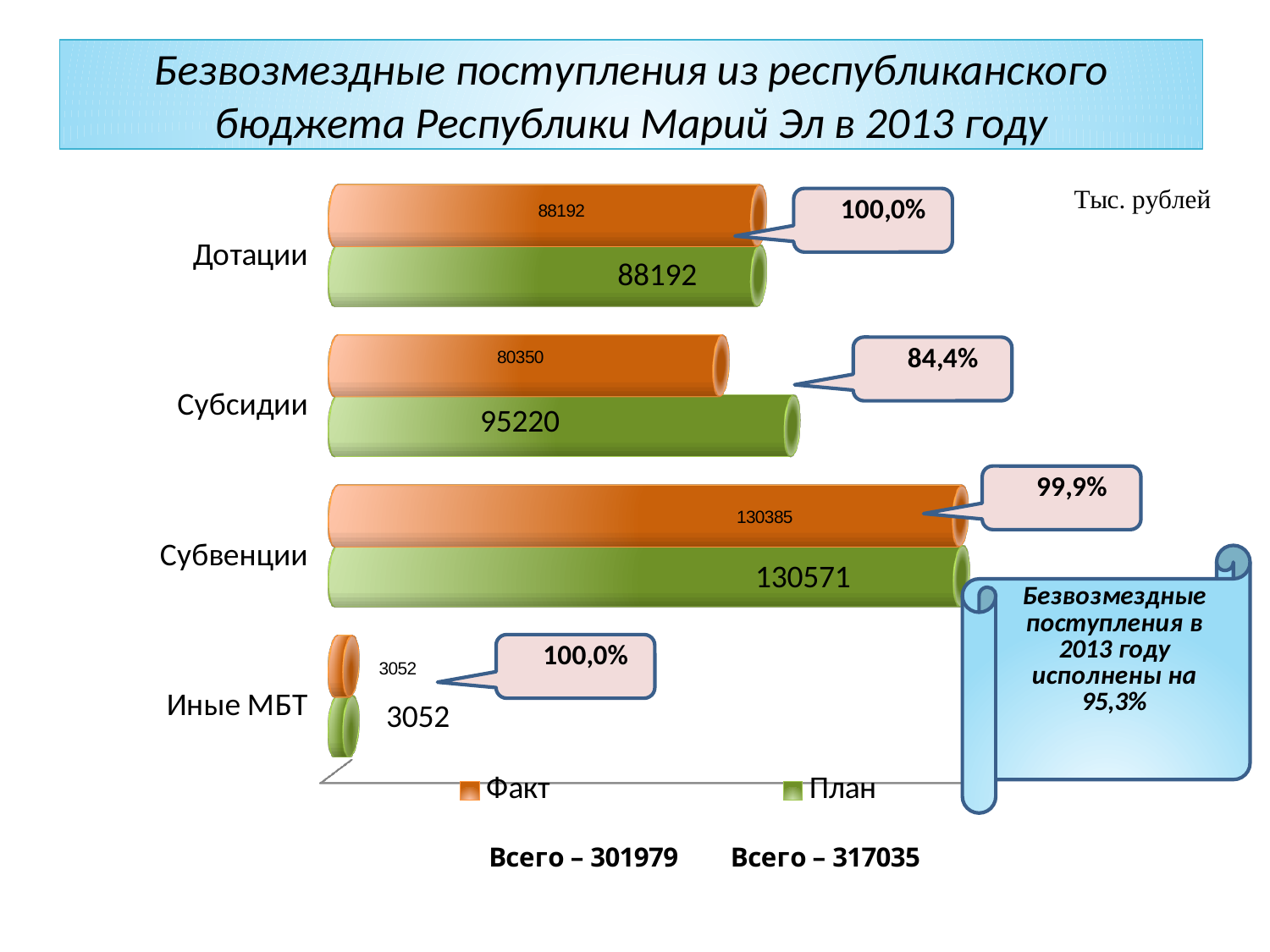
What is the difference between the План and Факт values for Субсидии? 14870 How many categories are shown on the chart? 4 What is the План value for Субсидии? 95220 What type of chart is shown on the slide? Bar chart What percentage is shown in the callout for Субсидии? 84,4% How many series does the legend list? 2 Which is larger for Субвенции, the Факт value or the План value? План What is the Факт value for Иные МБТ? 3052 What is the План value for Субвенции? 130571 What is the Факт value for Субсидии? 80350 Which category has the lowest План value? Иные МБТ Which category has the highest Факт value? Субвенции